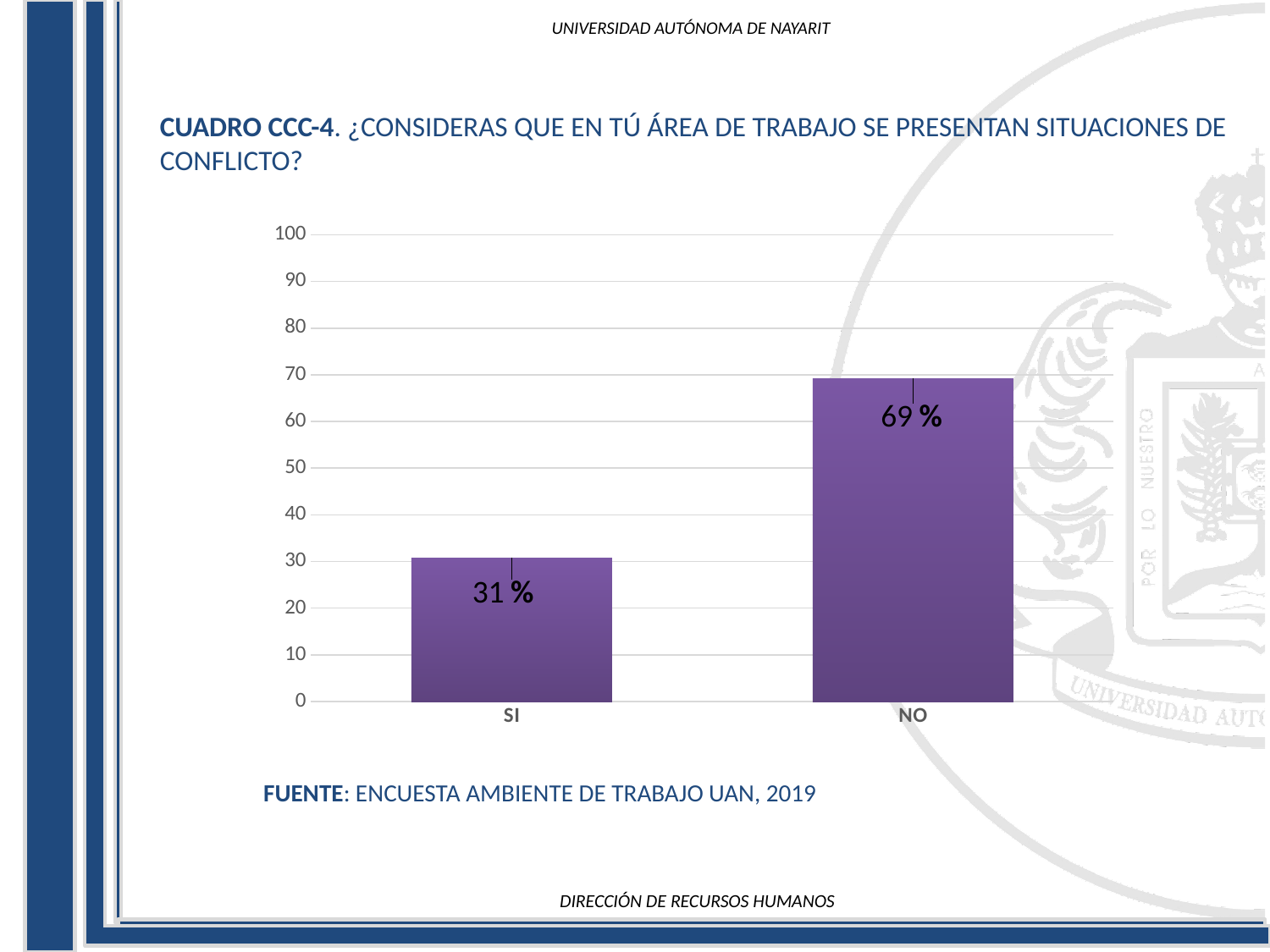
What is the difference between the values for NO and SI? 38 % Which category has the highest value? NO What is the highest value shown on the y axis? 100 Which is larger, the value for SI or the value for NO? NO Which category has the lowest value? SI What is the value for NO? 69 % How many categories are shown on the x axis? 2 Is the value for NO greater or less than 60? greater What is the value for SI? 31 % What kind of chart is shown on the slide? bar chart Is the value for SI greater or less than 40? less What source is cited below the chart? ENCUESTA AMBIENTE DE TRABAJO UAN, 2019